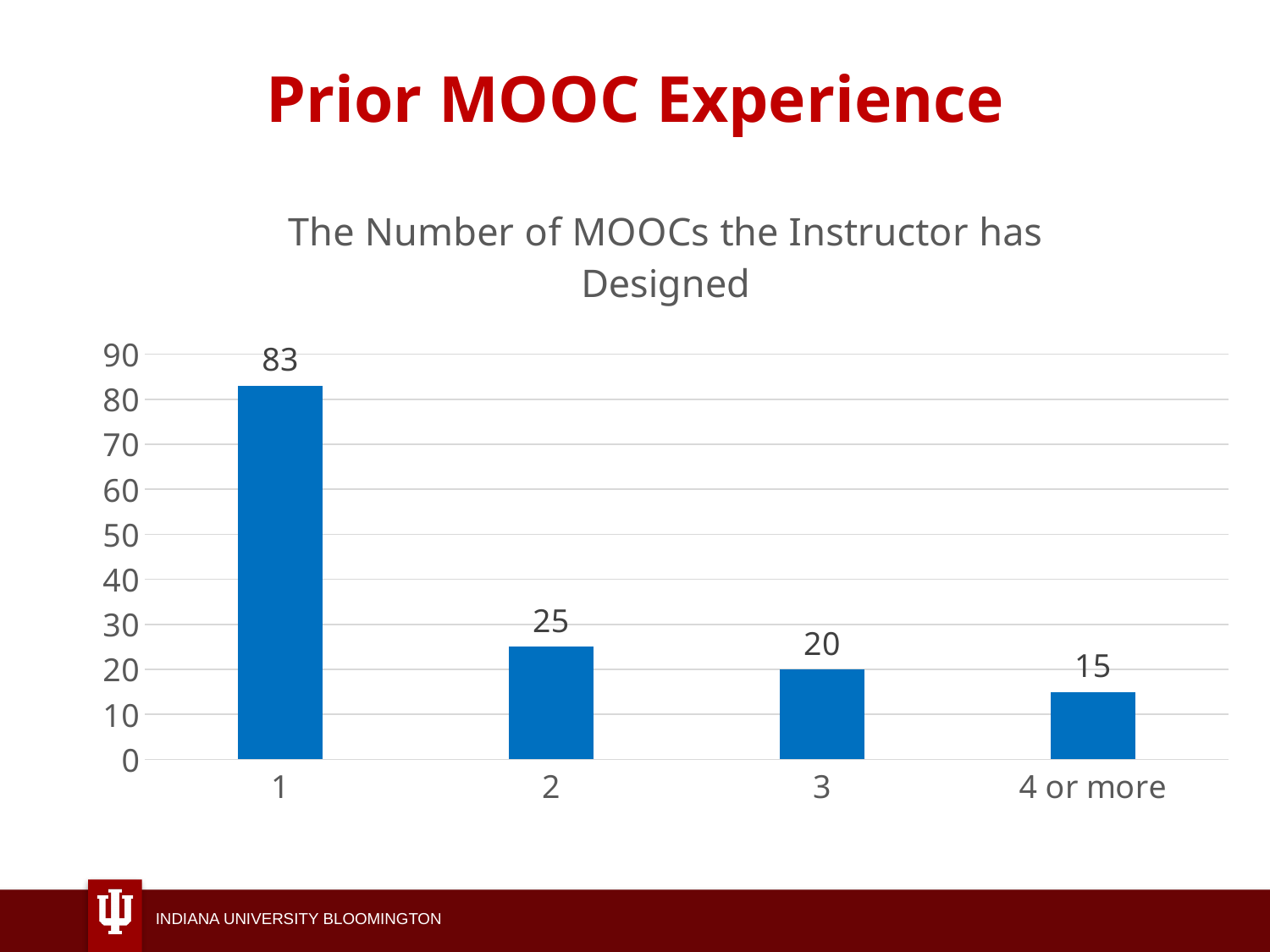
Which category has the lowest value? 4 or more What kind of chart is shown on the slide? bar chart What is the difference between the values for "3" and "4 or more"? 5 Is the value for "2" greater or less than 30? less What is the value for the category "3"? 20 What is the difference between the values for "1" and "2"? 58 What is the value for the category "1"? 83 Which category has the highest value? 1 What is the value for the category "4 or more"? 15 Which is larger, the value for "2" or the value for "3"? 2 Do the values rise or fall from left to right along the x axis? fall How many categories are shown on the x axis? 4